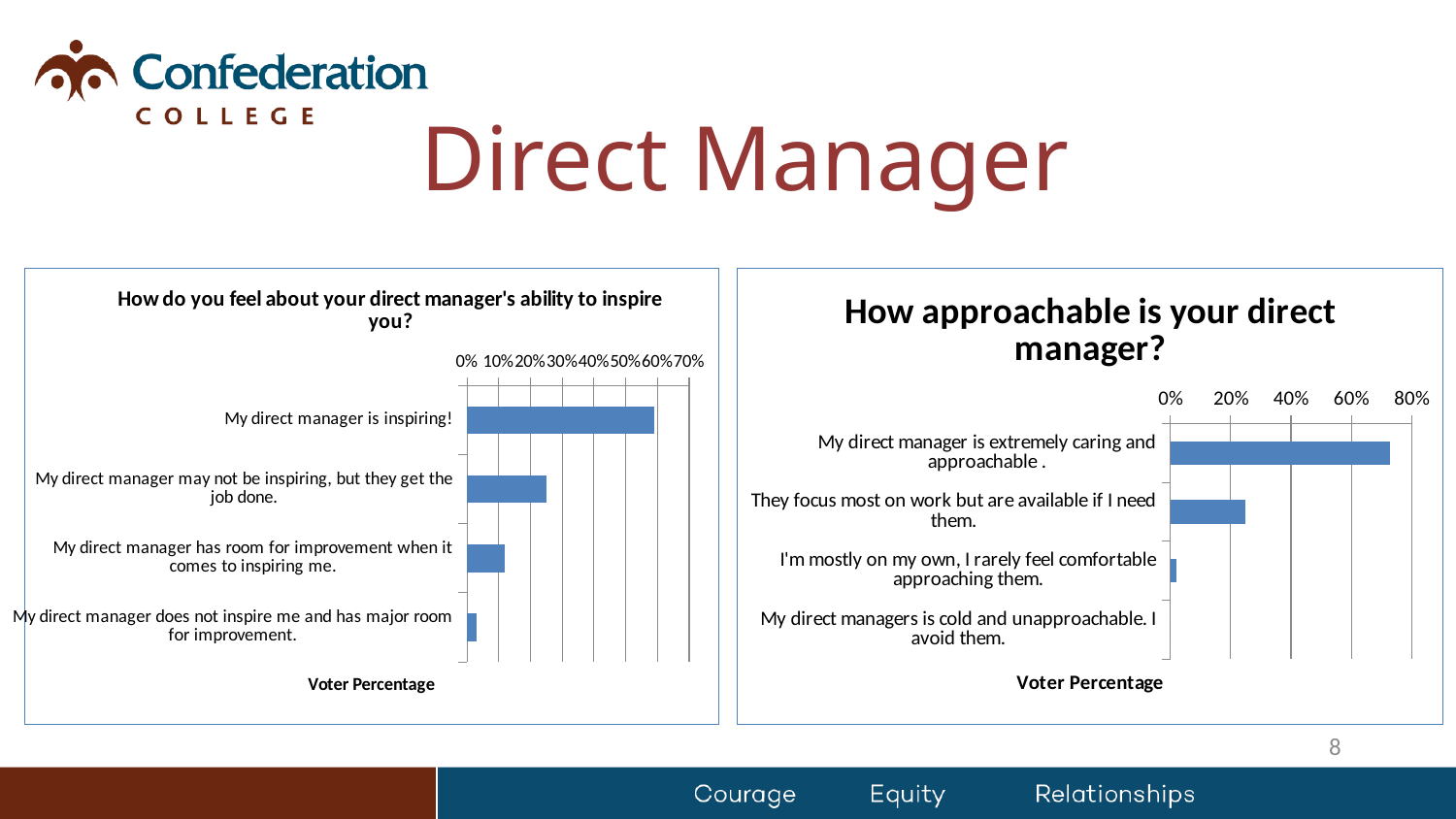
In the chart titled "How approachable is your direct manager?", which is larger: the value for "They focus most on work but are available if I need them." or the value for "I'm mostly on my own, I rarely feel comfortable approaching them."? They focus most on work but are available if I need them. In the chart titled "How do you feel about your direct manager's ability to inspire you?", is the value for "My direct manager is inspiring!" greater or less than 50%? greater In the chart titled "How do you feel about your direct manager's ability to inspire you?", what kind of chart is shown? Bar chart In the chart titled "How approachable is your direct manager?", how many categories are plotted? 4 In the chart titled "How do you feel about your direct manager's ability to inspire you?", how many categories are plotted? 4 In the chart titled "How approachable is your direct manager?", what is the highest value shown on the horizontal axis? 80% In the chart titled "How approachable is your direct manager?", is the value for "My direct manager is extremely caring and approachable ." greater or less than 60%? greater In the chart titled "How approachable is your direct manager?", which category has the highest value? My direct manager is extremely caring and approachable . In the chart titled "How do you feel about your direct manager's ability to inspire you?", which category has the highest value? My direct manager is inspiring! In the chart titled "How do you feel about your direct manager's ability to inspire you?", is the value for "My direct manager may not be inspiring, but they get the job done." greater or less than 30%? less In the chart titled "How do you feel about your direct manager's ability to inspire you?", which category has the lowest value? My direct manager does not inspire me and has major room for improvement. In the chart titled "How do you feel about your direct manager's ability to inspire you?", what is the label on the horizontal axis? Voter Percentage